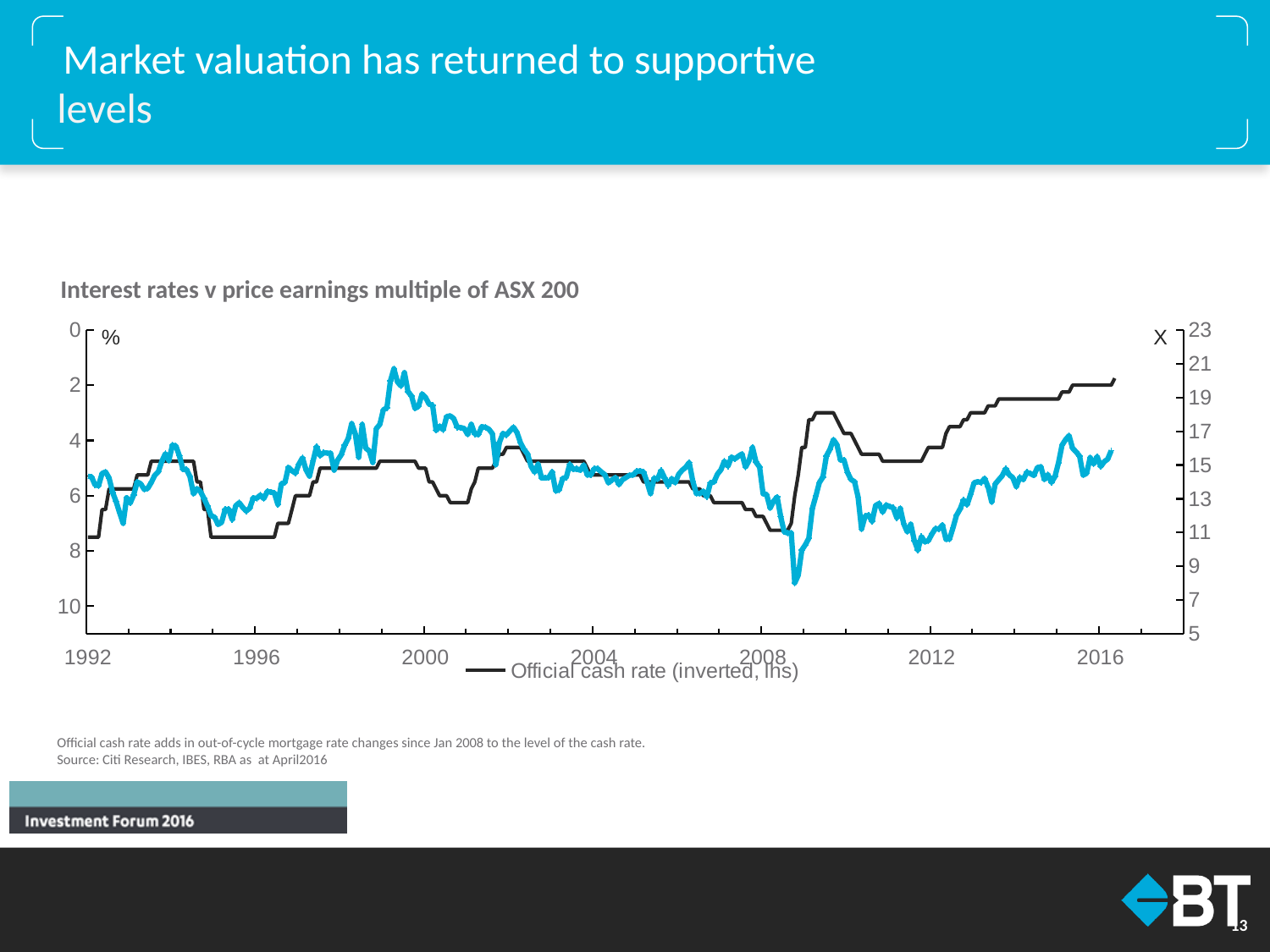
What is the last year labelled on the x axis? 2016 Does the blue line rise or fall between 2012 and 2016? rise What series name is shown in the chart's legend? Official cash rate (inverted, lhs) What is the title of the chart? Interest rates v price earnings multiple of ASX 200 Is the official cash rate (black line) in 2016 greater or less than 4%? less What is the first year labelled on the x axis? 1992 Is the official cash rate (black line) in 1996 greater or less than 6%? greater What is the highest value shown on the right-hand axis? 23 What kind of chart is shown on the slide? line chart How many year labels are shown along the x axis? 7 Is the lowest point of the blue line, reached around 2008, greater or less than 9 on the right-hand axis? less How many lines are plotted on the chart? 2